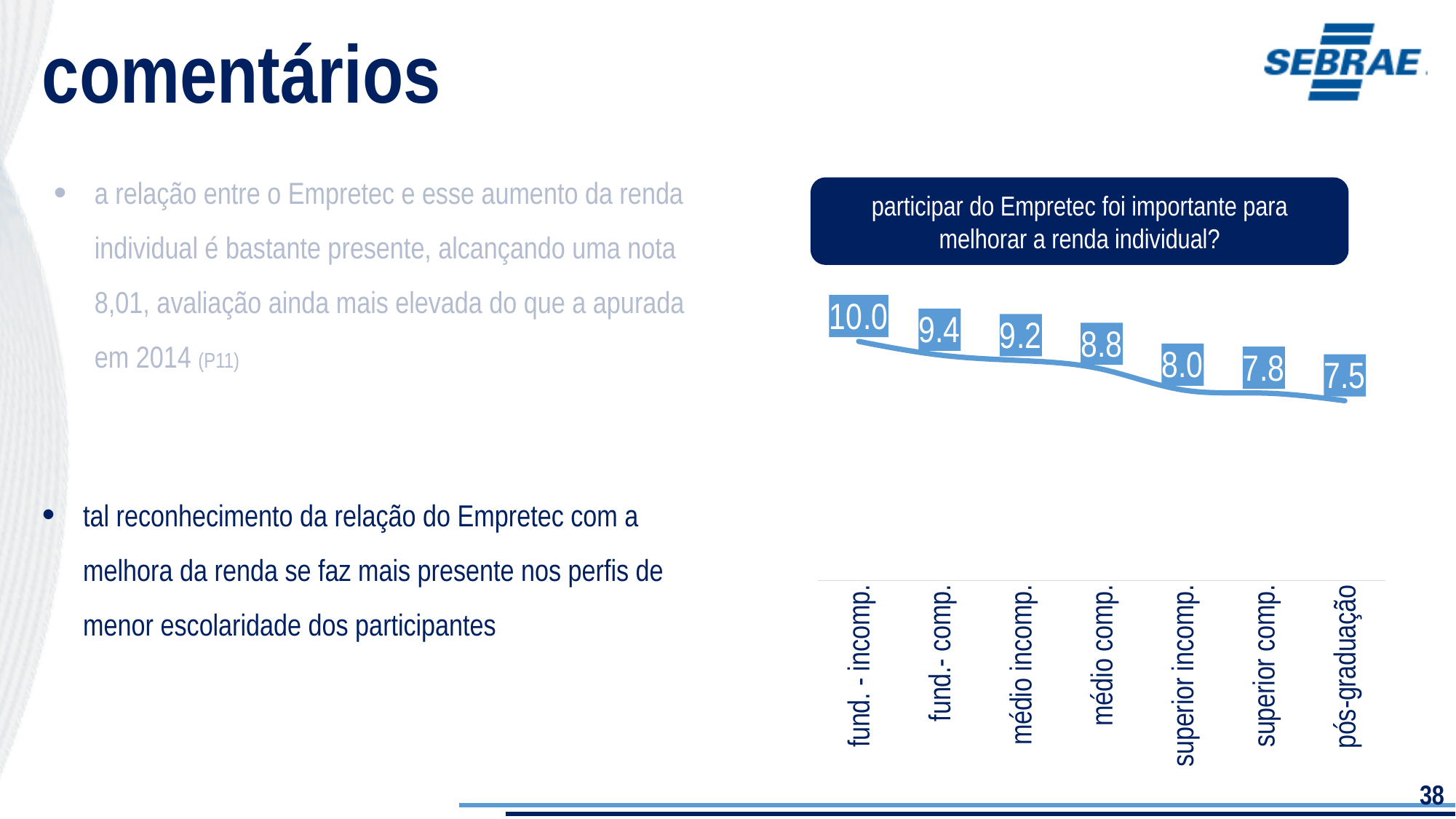
How many categories are plotted on the chart? 7 Which category has the highest value? fund. - incomp. What is the value for 'superior incomp.'? 8.0 What is the value for 'médio comp.'? 8.8 What is the difference between the values for 'fund. - incomp.' and 'pós-graduação'? 2.5 What is the title of the chart? participar do Empretec foi importante para melhorar a renda individual? What is the value for 'pós-graduação'? 7.5 What kind of chart is shown on the slide? line chart Which category has the lowest value? pós-graduação Do the values rise or fall from left to right along the x axis? fall What is the value for 'fund. - incomp.'? 10.0 Which is larger, the value for 'fund.- comp.' or the value for 'superior comp.'? fund.- comp.